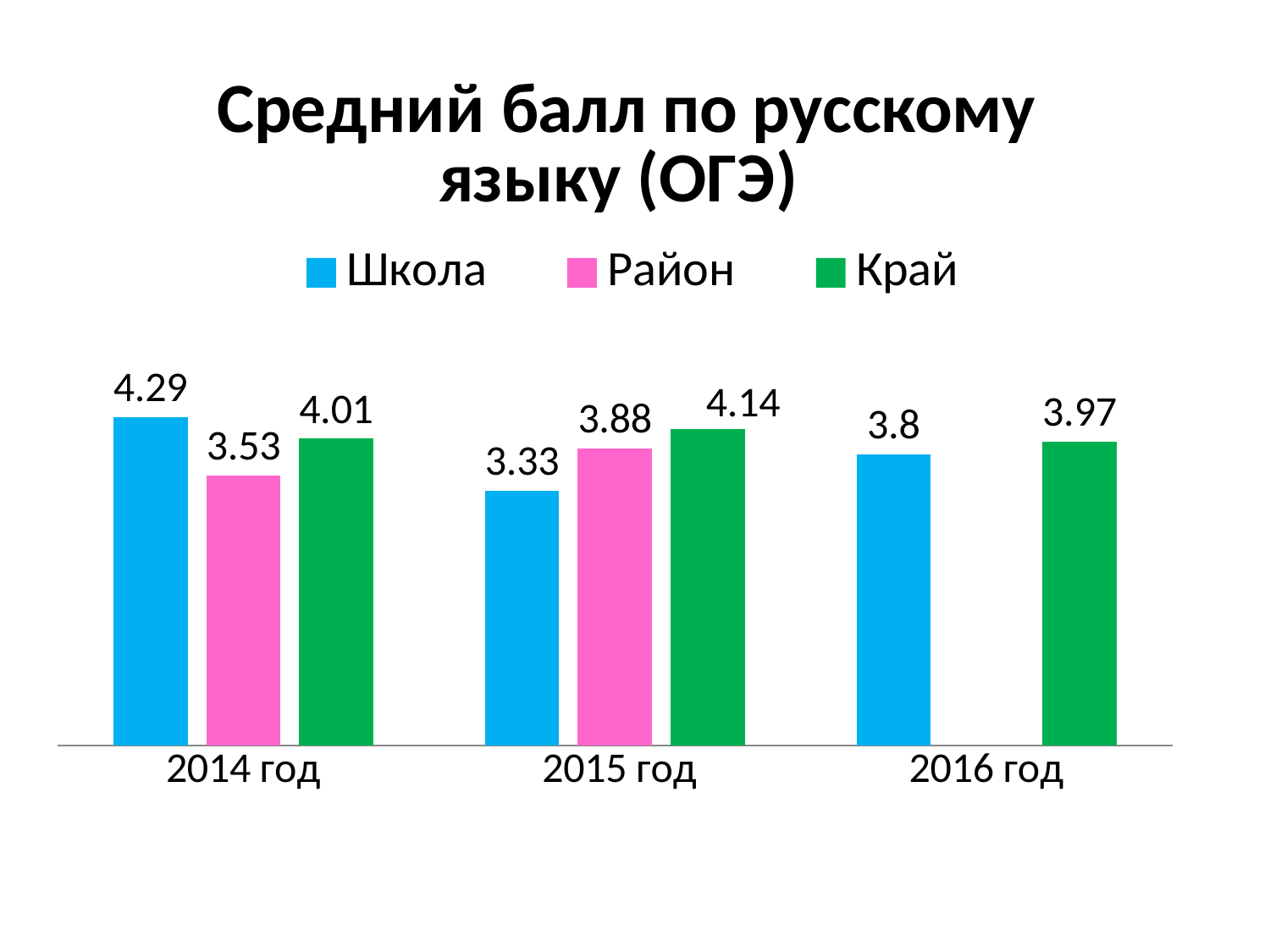
How many series does the legend list? 3 What is the value for Край in 2016 год? 3.97 Does the Край value rise or fall from 2015 год to 2016 год? Fall What is the value for Район in 2015 год? 3.88 In which year is the Школа value highest? 2014 год How many year categories are shown on the x axis? 3 What is the difference between the Край and Школа values in 2015 год? 0.81 In which year is the Школа value lowest? 2015 год What is the value for Школа in 2014 год? 4.29 Which is larger in 2014 год: Школа or Край? Школа What kind of chart is this? Bar chart Which series is shown in pink? Район